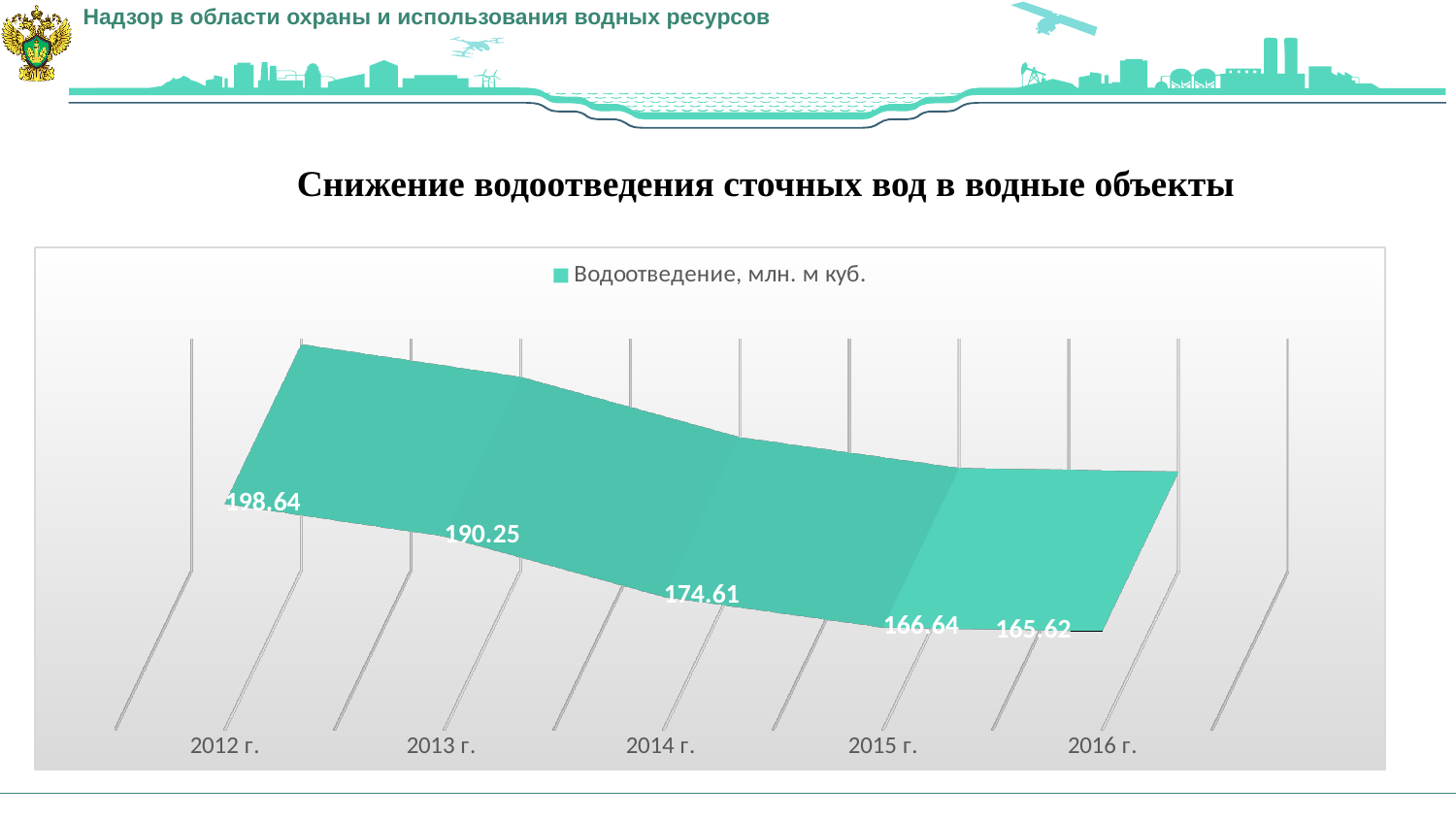
How many years are shown on the x axis? 5 What is the value for 2013 г.? 190.25 Which year has the highest value? 2012 г. What is the value for 2012 г.? 198.64 What is the difference between the values for 2013 г. and 2014 г.? 15.64 Which year has the lowest value? 2016 г. What series name does the legend show? Водоотведение, млн. м куб. What is the value for 2016 г.? 165.62 Which is larger, the value for 2014 г. or the value for 2015 г.? 2014 г. Do the values rise or fall from 2012 г. to 2016 г.? fall What is the value for 2014 г.? 174.61 What is the difference between the values for 2012 г. and 2016 г.? 33.02